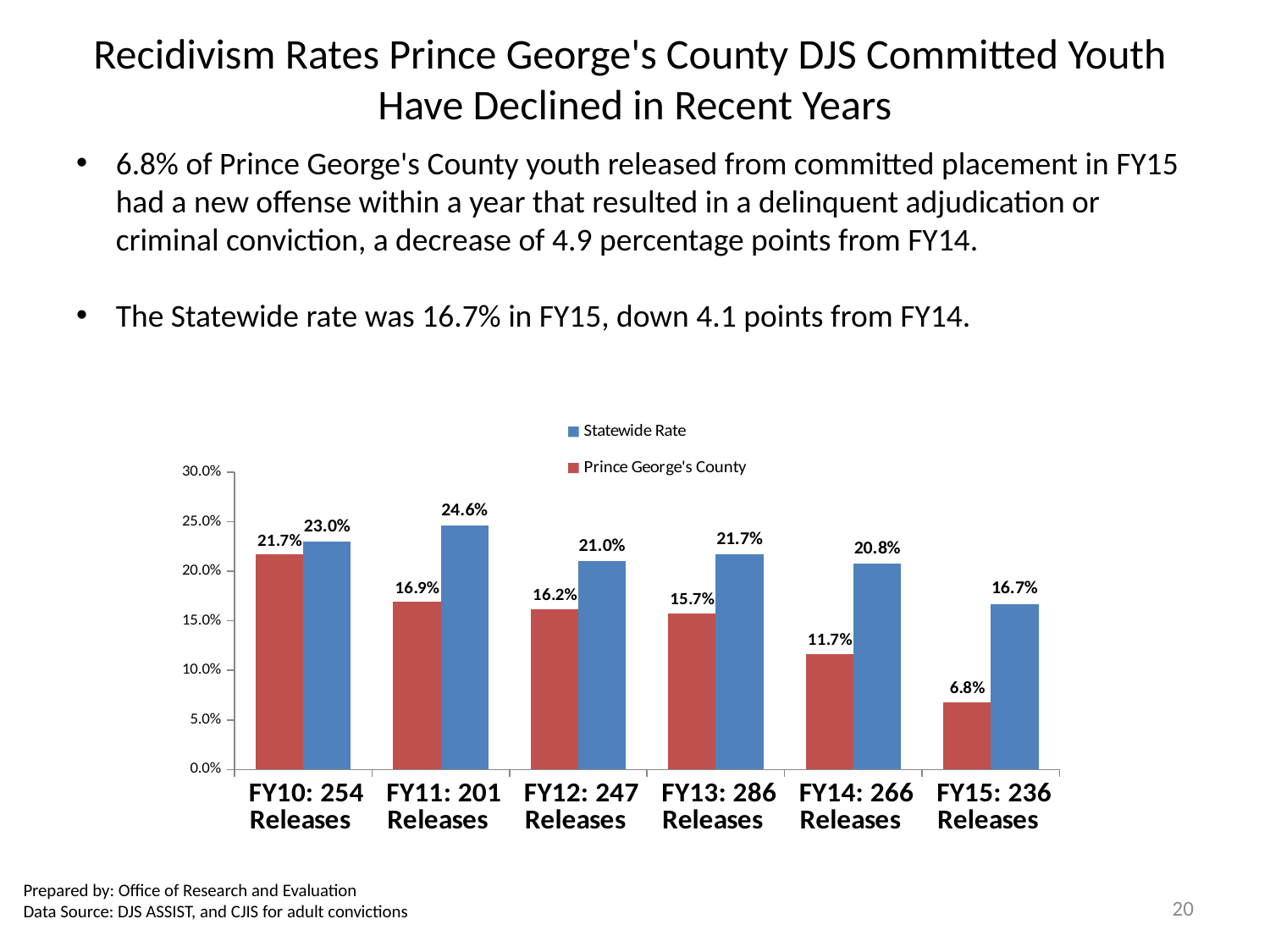
What is the Statewide Rate for FY11: 201 Releases? 24.6% What is the Prince George's County recidivism rate for FY15: 236 Releases? 6.8% Which colour represents the Statewide Rate in the chart? blue What is the Prince George's County rate for FY13: 286 Releases? 15.7% How many fiscal year categories are shown on the x axis? 6 Which category has the lowest Prince George's County rate? FY15: 236 Releases What is the difference between the Statewide Rate and the Prince George's County rate for FY14: 266 Releases? 9.1% What kind of chart is shown on the slide? bar chart Which is larger for FY10: 254 Releases, the Statewide Rate or the Prince George's County rate? Statewide Rate Is the Prince George's County rate for FY12: 247 Releases greater or less than 20.0%? less How many series does the legend list? 2 Which category has the highest Statewide Rate? FY11: 201 Releases